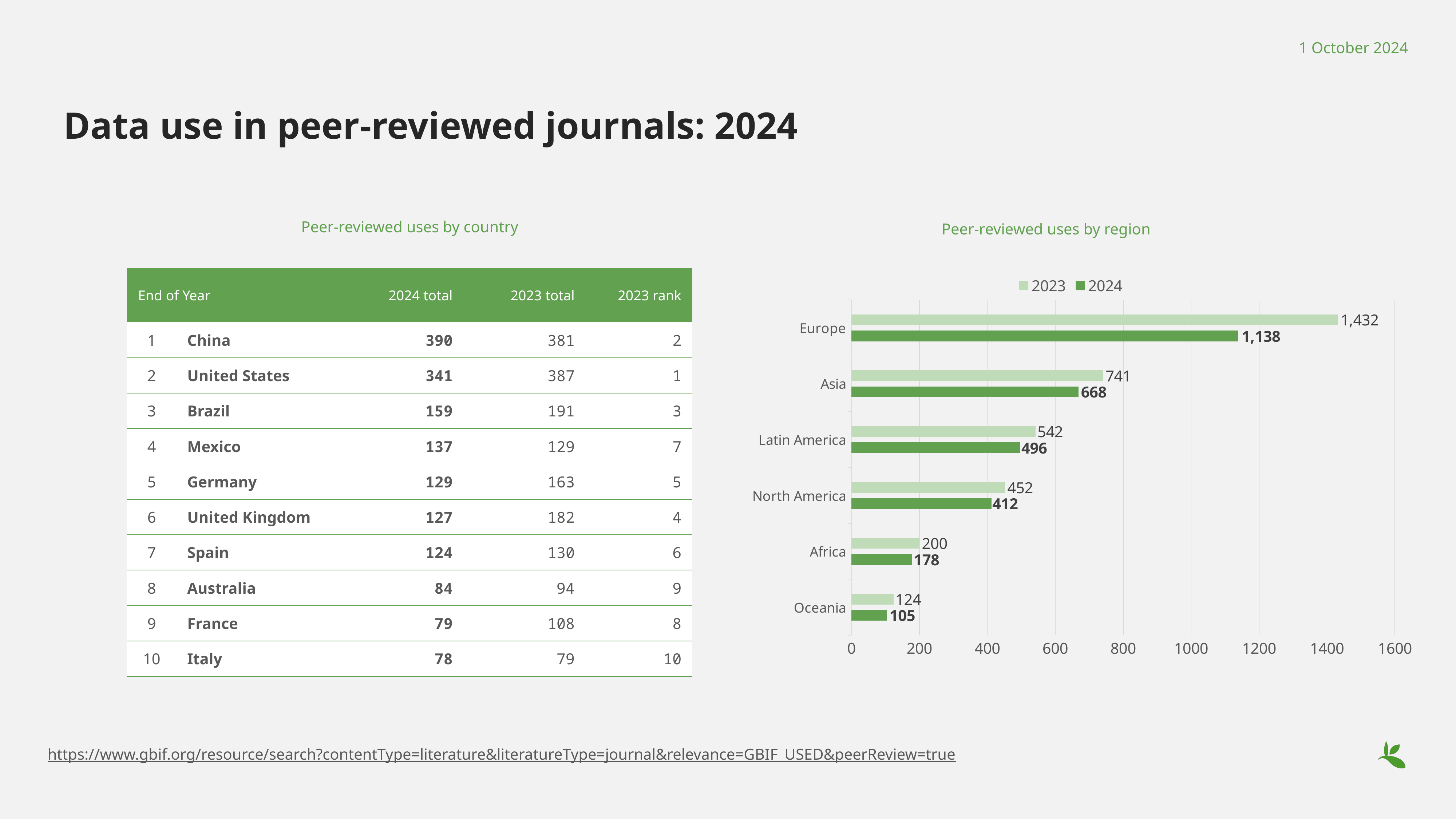
In the 'Peer-reviewed uses by region' chart, which region has the lowest 2023 value? Oceania In the 'Peer-reviewed uses by region' chart, what is the 2024 value for Europe? 1,138 In the 'Peer-reviewed uses by region' chart, what is the difference between the 2023 and 2024 values for Latin America? 46 In the 'Peer-reviewed uses by region' chart, what is the difference between the 2023 and 2024 values for Europe? 294 In the 'Peer-reviewed uses by region' chart, what is the 2024 value for Oceania? 105 In the 'Peer-reviewed uses by region' chart, which is larger: the 2024 value for Asia or the 2023 value for Latin America? 2024 value for Asia How many regions are shown in the 'Peer-reviewed uses by region' chart? 6 In the 'Peer-reviewed uses by region' chart, is the 2024 value for North America greater or less than 400? greater What kind of chart is 'Peer-reviewed uses by region'? Bar chart In the 'Peer-reviewed uses by region' chart, what is the 2023 value for Asia? 741 How many series does the legend of the 'Peer-reviewed uses by region' chart list? 2 In the 'Peer-reviewed uses by region' chart, which region has the highest 2024 value? Europe